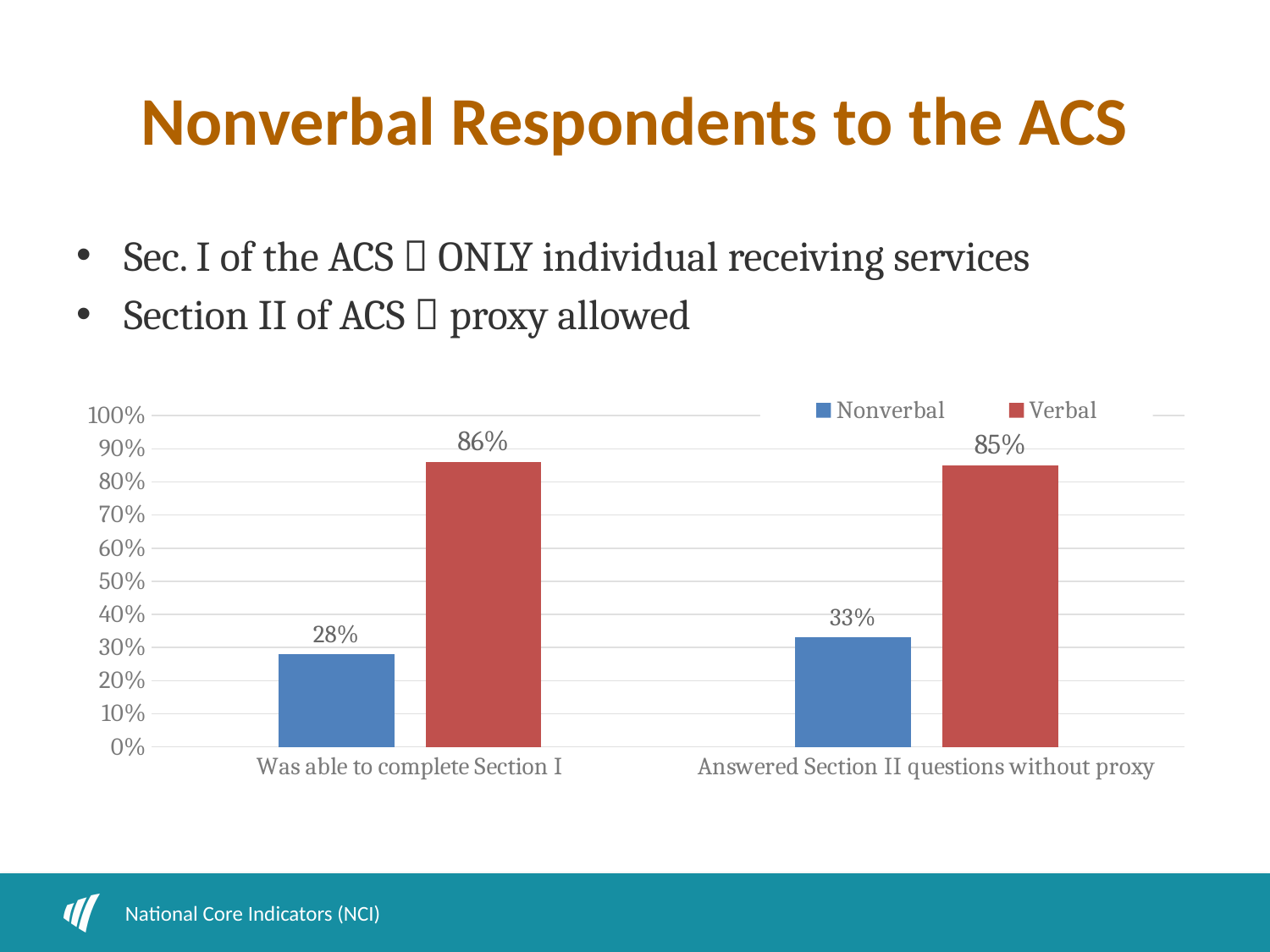
How many categories are shown on the x axis? 2 What percentage of Verbal respondents answered Section II questions without proxy? 85% What is the difference between the Verbal and Nonverbal values for 'Answered Section II questions without proxy'? 52% What is the difference between the Verbal and Nonverbal values for 'Was able to complete Section I'? 58% Which bar in the chart has the lowest value? Nonverbal, Was able to complete Section I What colour represents the Verbal series in the chart? Red Which series has the higher value for 'Was able to complete Section I'? Verbal What kind of chart is shown on the slide? Bar chart What percentage of Nonverbal respondents was able to complete Section I? 28% What percentage of Verbal respondents was able to complete Section I? 86% What percentage of Nonverbal respondents answered Section II questions without proxy? 33% How many series does the legend list? 2